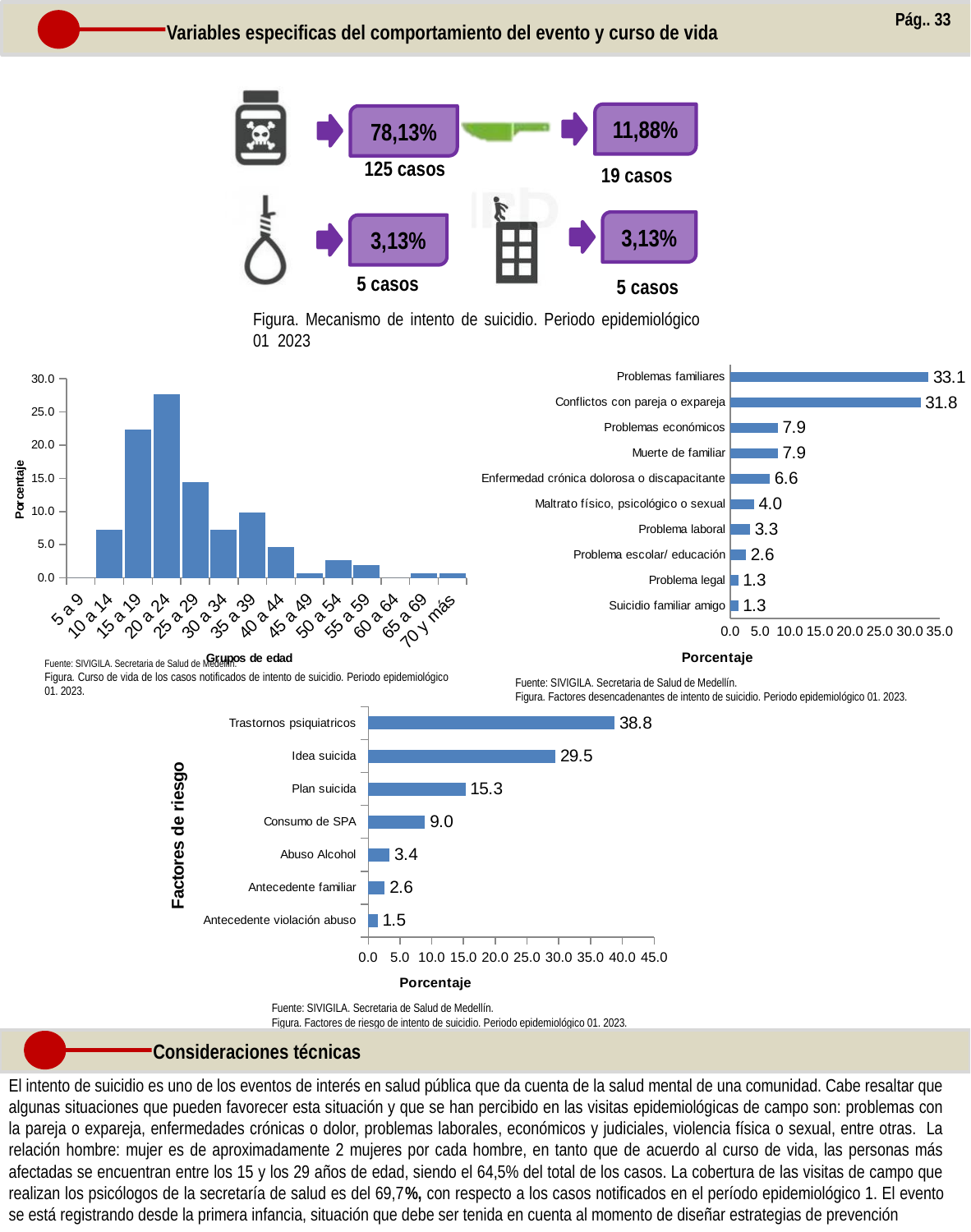
In the chart titled 'Factores de riesgo de intento de suicidio', what is the difference between Trastornos psiquiatricos and Idea suicida? 9.3 In the chart titled 'Factores desencadenantes de intento de suicidio', what is the value for Enfermedad crónica dolorosa o discapacitante? 6.6 In the chart titled 'Factores desencadenantes de intento de suicidio', which category has the highest value? Problemas familiares In the chart titled 'Factores desencadenantes de intento de suicidio', which is larger: Problema laboral or Problema escolar/ educación? Problema laboral In the chart titled 'Factores de riesgo de intento de suicidio', what is the value for Consumo de SPA? 9.0 How many categories are shown in the chart titled 'Factores desencadenantes de intento de suicidio'? 10 How many age groups are shown on the x axis of the chart titled 'Curso de vida de los casos notificados de intento de suicidio'? 14 In the chart titled 'Factores desencadenantes de intento de suicidio', what is the difference between Problemas familiares and Conflictos con pareja o expareja? 1.3 In the chart titled 'Curso de vida de los casos notificados de intento de suicidio', is the value for 15 a 19 greater or less than 20.0? greater What kind of chart is the one titled 'Factores de riesgo de intento de suicidio'? Bar chart In the chart titled 'Curso de vida de los casos notificados de intento de suicidio', which age group has the highest percentage? 20 a 24 In the chart titled 'Factores de riesgo de intento de suicidio', which category has the lowest value? Antecedente violación abuso